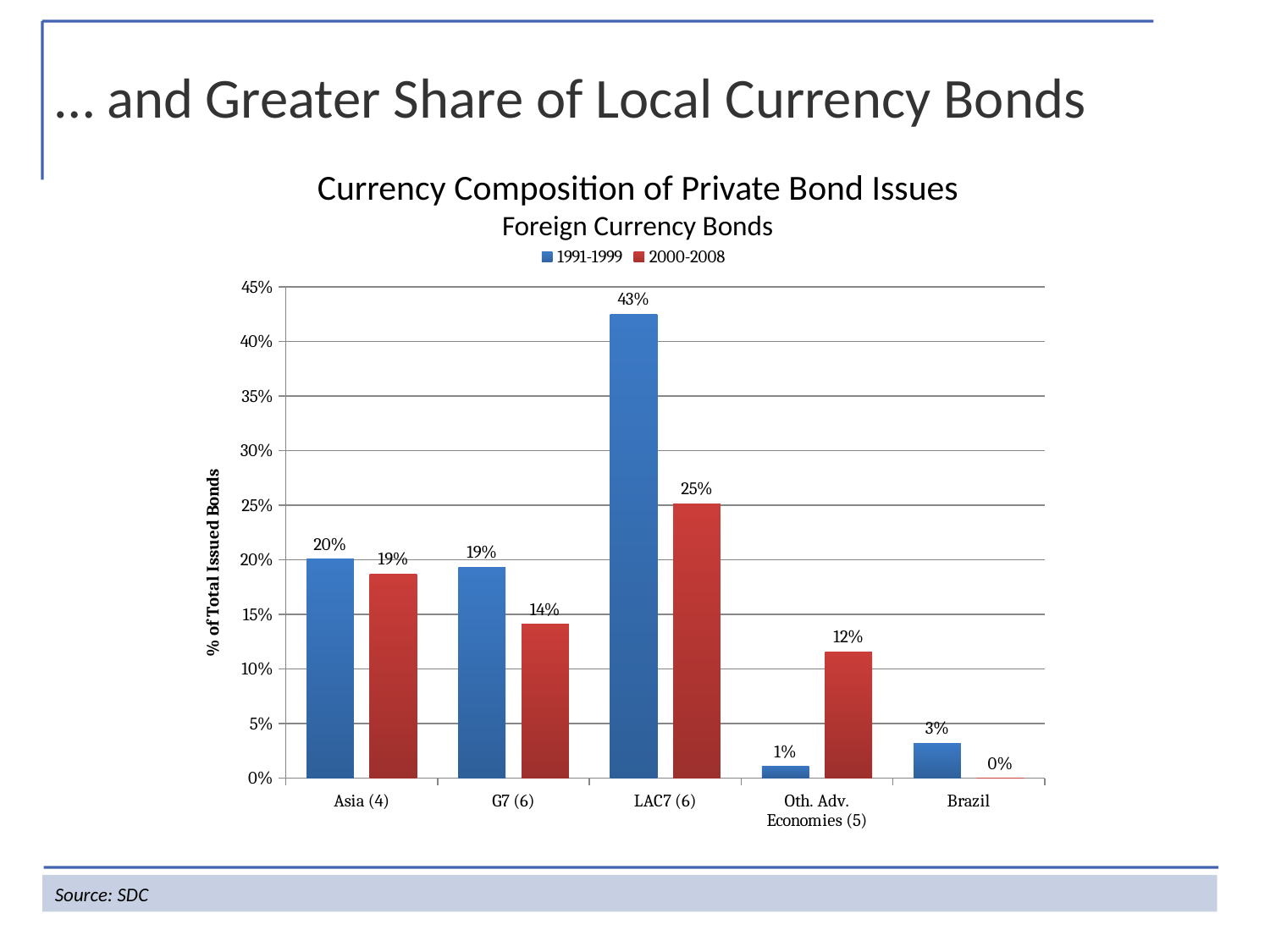
How many categories are shown on the x axis? 5 What is the label of the vertical axis? % of Total Issued Bonds For Oth. Adv. Economies (5), which series has the larger value, 1991-1999 or 2000-2008? 2000-2008 What is the value for LAC7 (6) in the 1991-1999 series? 43% What is the value for Brazil in the 2000-2008 series? 0% What kind of chart is shown on the slide? bar chart How many series does the legend list? 2 What is the difference between the 1991-1999 and 2000-2008 values for LAC7 (6)? 18% What is the value for G7 (6) in the 2000-2008 series? 14% Which category has the highest value in the 1991-1999 series? LAC7 (6) Is the 2000-2008 value for Asia (4) greater or less than 15%? greater Which category has the lowest value in the 2000-2008 series? Brazil